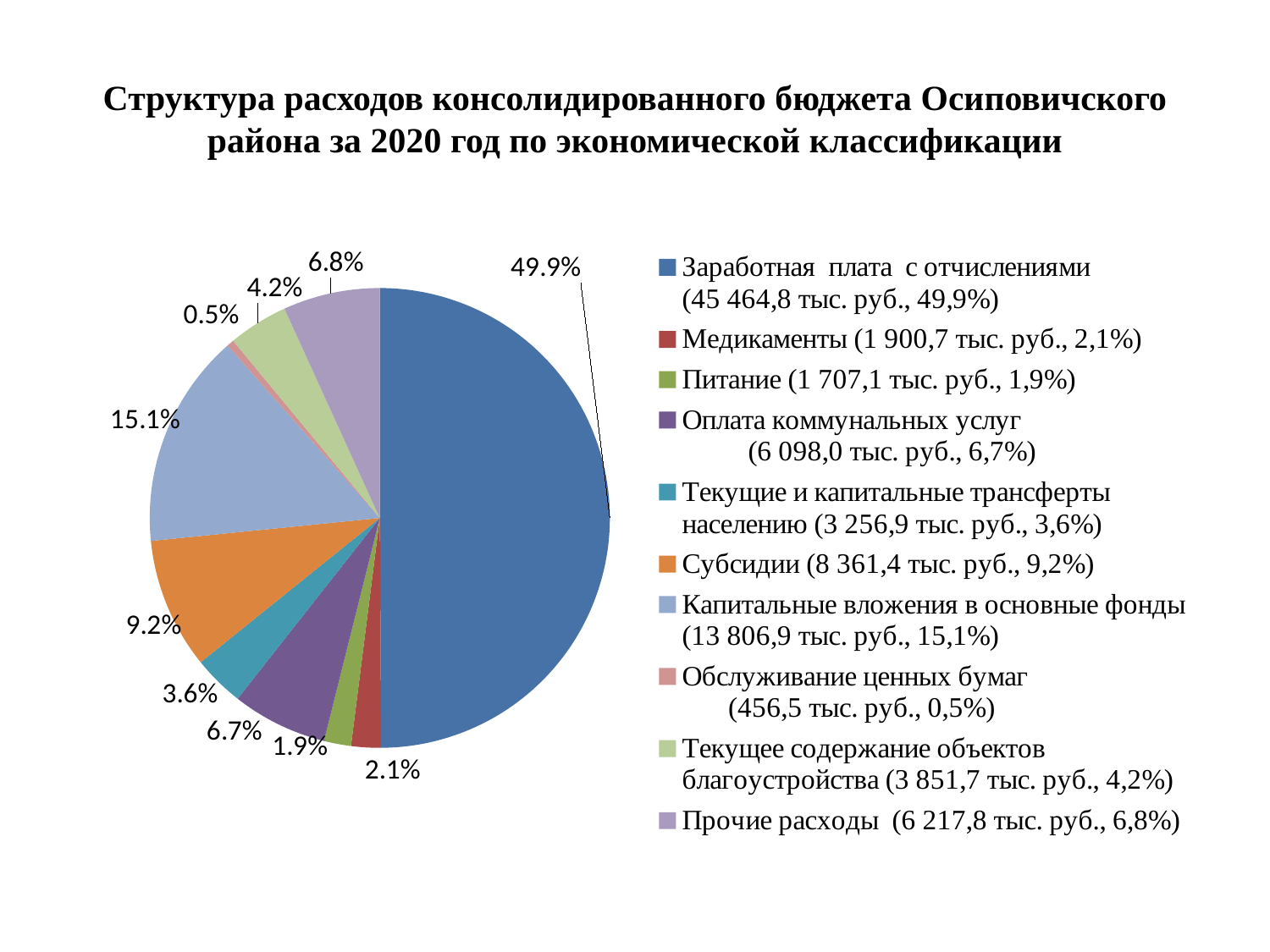
What kind of chart is shown on the slide? Pie chart How many slices does the pie chart have? 10 Which category has the largest slice of the pie? Заработная плата с отчислениями What share of the pie does "Заработная плата с отчислениями" take? 49.9% What is the title of the slide's chart? Структура расходов консолидированного бюджета Осиповичского района за 2020 год по экономической классификации Which category has the smallest slice of the pie? Обслуживание ценных бумаг What is the difference in percentage points between the shares of "Капитальные вложения в основные фонды" and "Субсидии"? 5.9 percentage points How many entries does the legend list? 10 According to the legend, what amount in thousand rubles corresponds to "Капитальные вложения в основные фонды"? 13 806,9 тыс. руб. Which slice is larger: "Медикаменты" or "Питание"? Медикаменты What share of the pie does "Прочие расходы" take? 6.8% What share of the pie does "Субсидии" take? 9.2%